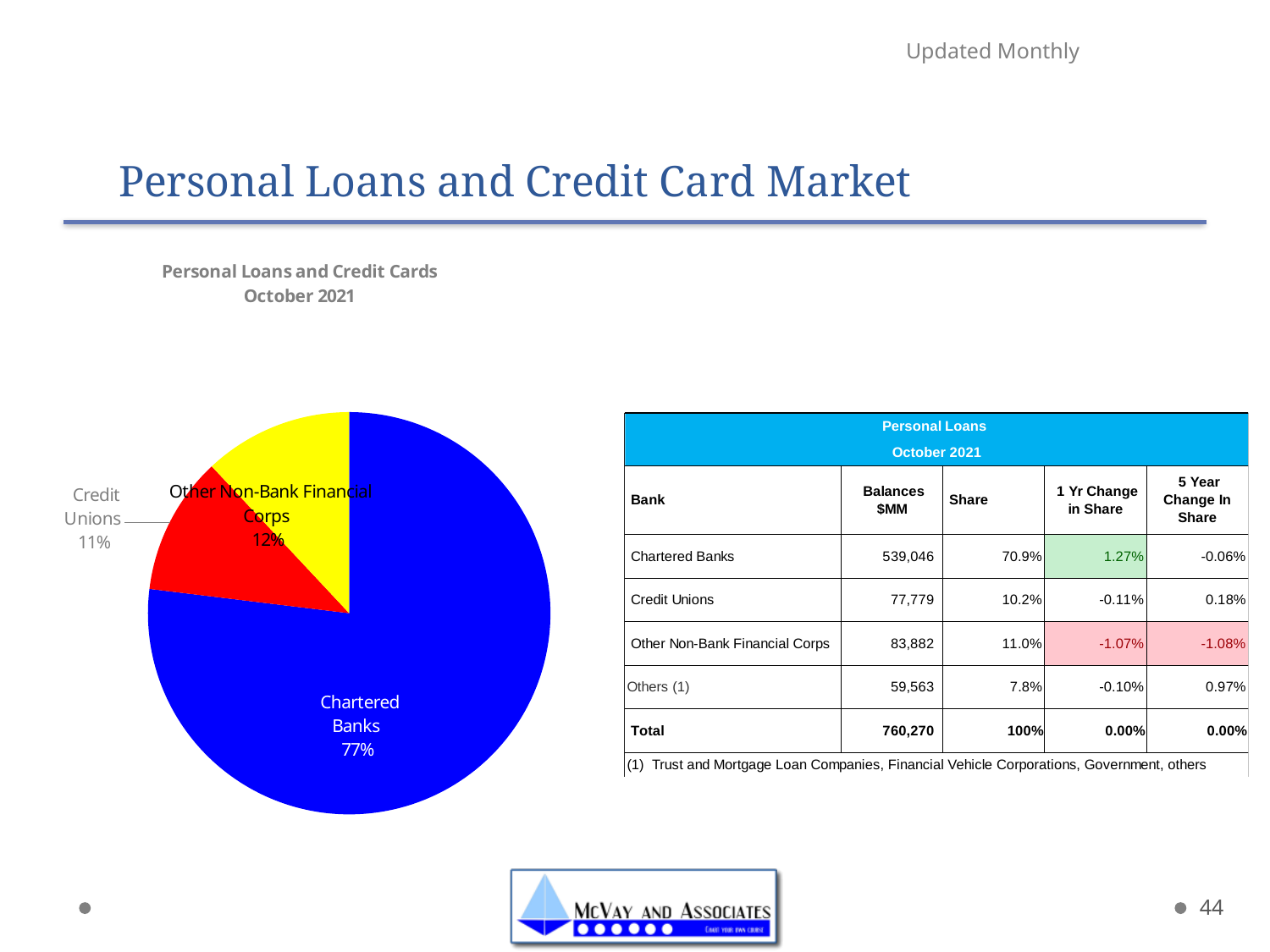
Which category has the smallest slice in the pie chart? Credit Unions What share of the pie chart does Credit Unions hold? 11% What colour is the Chartered Banks slice in the pie chart? Blue Which category has the largest slice in the pie chart? Chartered Banks What is the title of the pie chart? Personal Loans and Credit Cards October 2021 What share of the pie chart does Other Non-Bank Financial Corps hold? 12% Which slice is larger in the pie chart, Chartered Banks or Credit Unions? Chartered Banks What type of chart is shown on the slide? Pie chart What is the difference in percentage points between the Other Non-Bank Financial Corps slice and the Credit Unions slice? 1 How many slices does the pie chart have? 3 What share of the pie chart does Chartered Banks hold? 77% What is the difference in percentage points between the Chartered Banks slice and the Other Non-Bank Financial Corps slice? 65